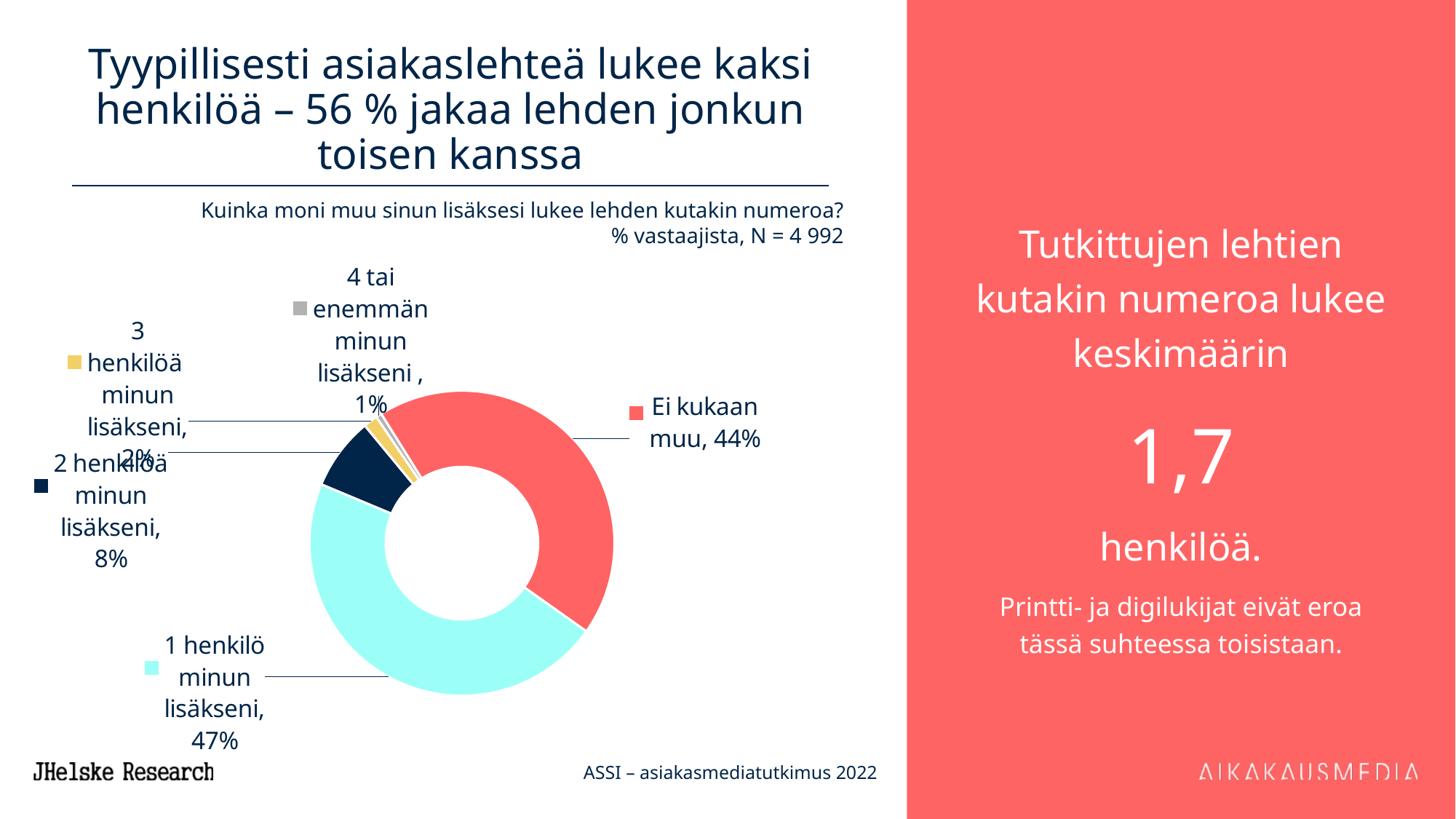
What kind of chart is shown on the slide? Donut (pie) chart What share of respondents answered "2 henkilöä minun lisäkseni"? 8% What share of respondents answered "1 henkilö minun lisäkseni"? 47% What share of respondents answered "Ei kukaan muu"? 44% What is the difference in percentage points between "1 henkilö minun lisäkseni" and "Ei kukaan muu"? 3 percentage points Which category has the largest share in the chart? 1 henkilö minun lisäkseni What is the number of respondents (N) stated above the chart? 4 992 What colour is the "Ei kukaan muu" slice? Red How many categories does the chart show? 5 Which is larger: the share for "2 henkilöä minun lisäkseni" or for "3 henkilöä minun lisäkseni"? 2 henkilöä minun lisäkseni What share of respondents answered "4 tai enemmän minun lisäkseni"? 1% Which category has the smallest share in the chart? 4 tai enemmän minun lisäkseni